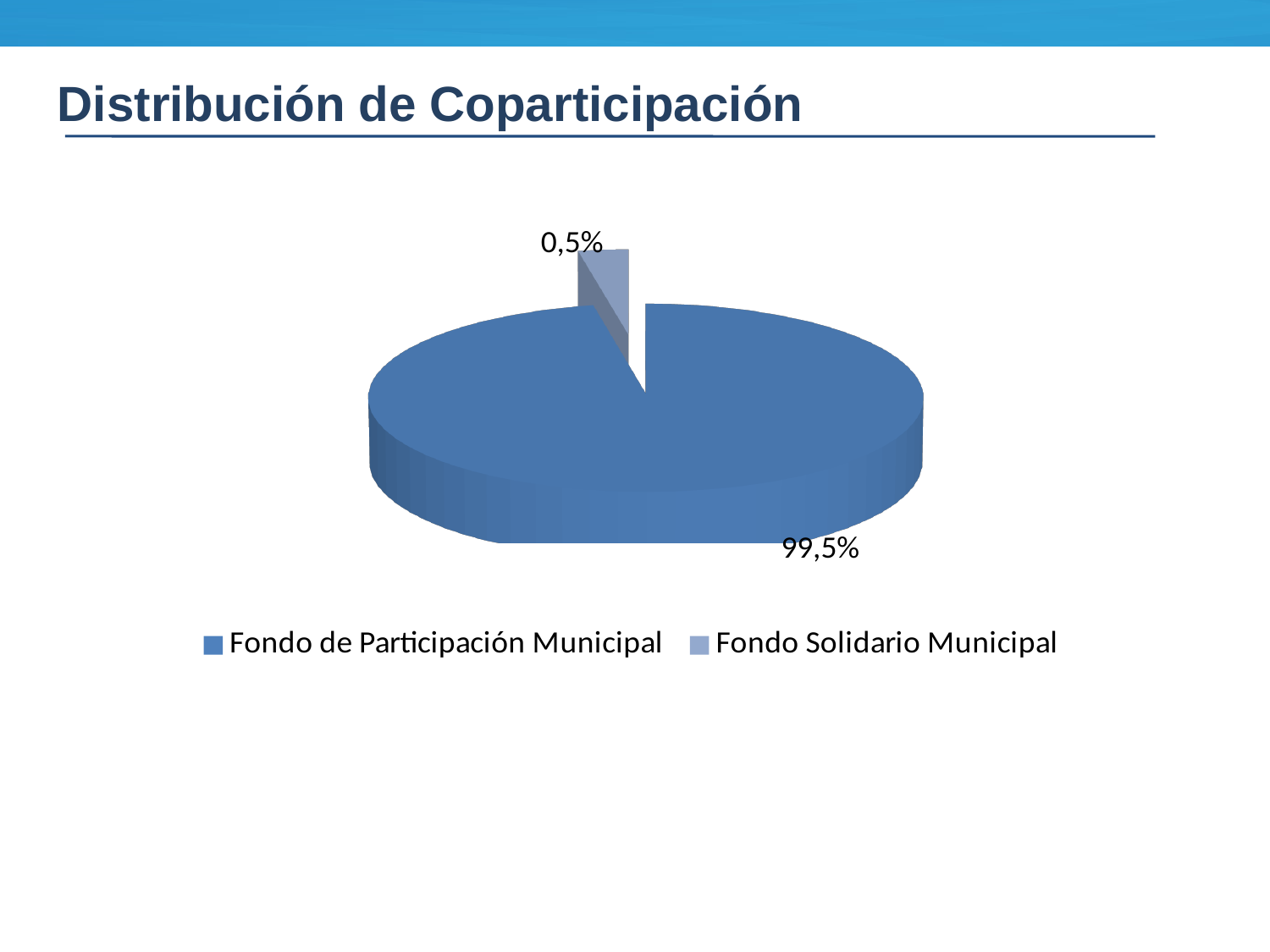
How many entries does the legend list? 2 What is the difference in percentage points between Fondo de Participación Municipal and Fondo Solidario Municipal? 99 percentage points What share of the pie does Fondo Solidario Municipal have? 0,5% What share of the pie does Fondo de Participación Municipal have? 99,5% Which legend entry is shown in the lighter blue colour? Fondo Solidario Municipal How many slices does the pie chart have? 2 What is the title of the slide containing the chart? Distribución de Coparticipación What is the total of the two percentages shown on the pie chart? 100% What kind of chart is shown on the slide? Pie chart Which category has the largest slice of the pie? Fondo de Participación Municipal Which category has the smallest slice of the pie? Fondo Solidario Municipal Which is larger, the slice for Fondo de Participación Municipal or the slice for Fondo Solidario Municipal? Fondo de Participación Municipal